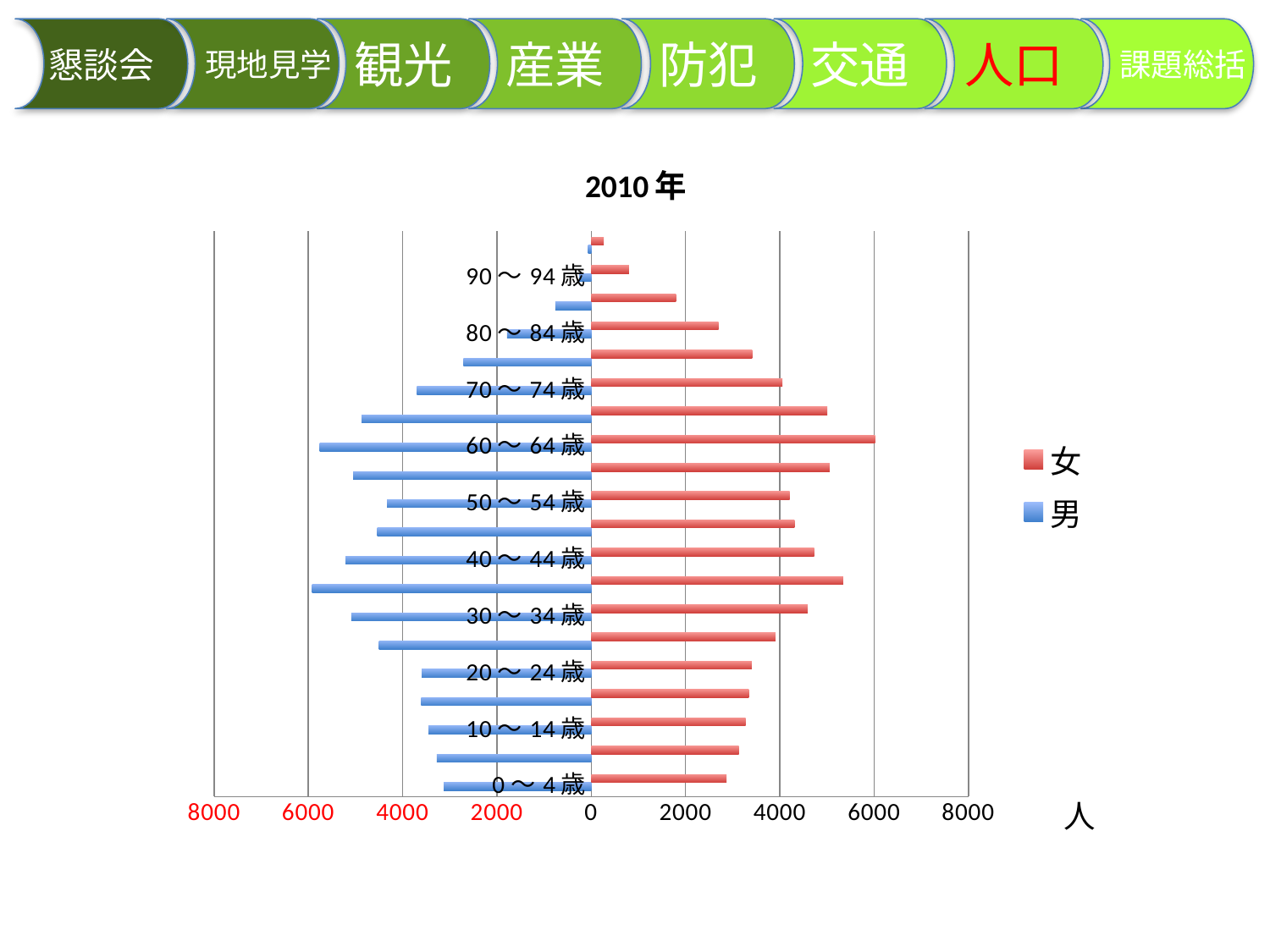
Which is larger for 男, the value for 60～64歳 or the value for 80～84歳? 60～64歳 What is the title of the chart? 2010年 What kind of chart is shown on the slide? bar chart How many series does the legend list? 2 Is the value for 女 in the 60～64歳 group greater or less than 5000? greater Is the value for 男 in the 90～94歳 group greater or less than 2000? less Which age group has the highest value for 女? 60～64歳 Is the value for 女 in the 0～4歳 group greater or less than 4000? less Which is larger for the 80～84歳 group, the value for 女 or the value for 男? 女 Which colour represents the 女 series? red